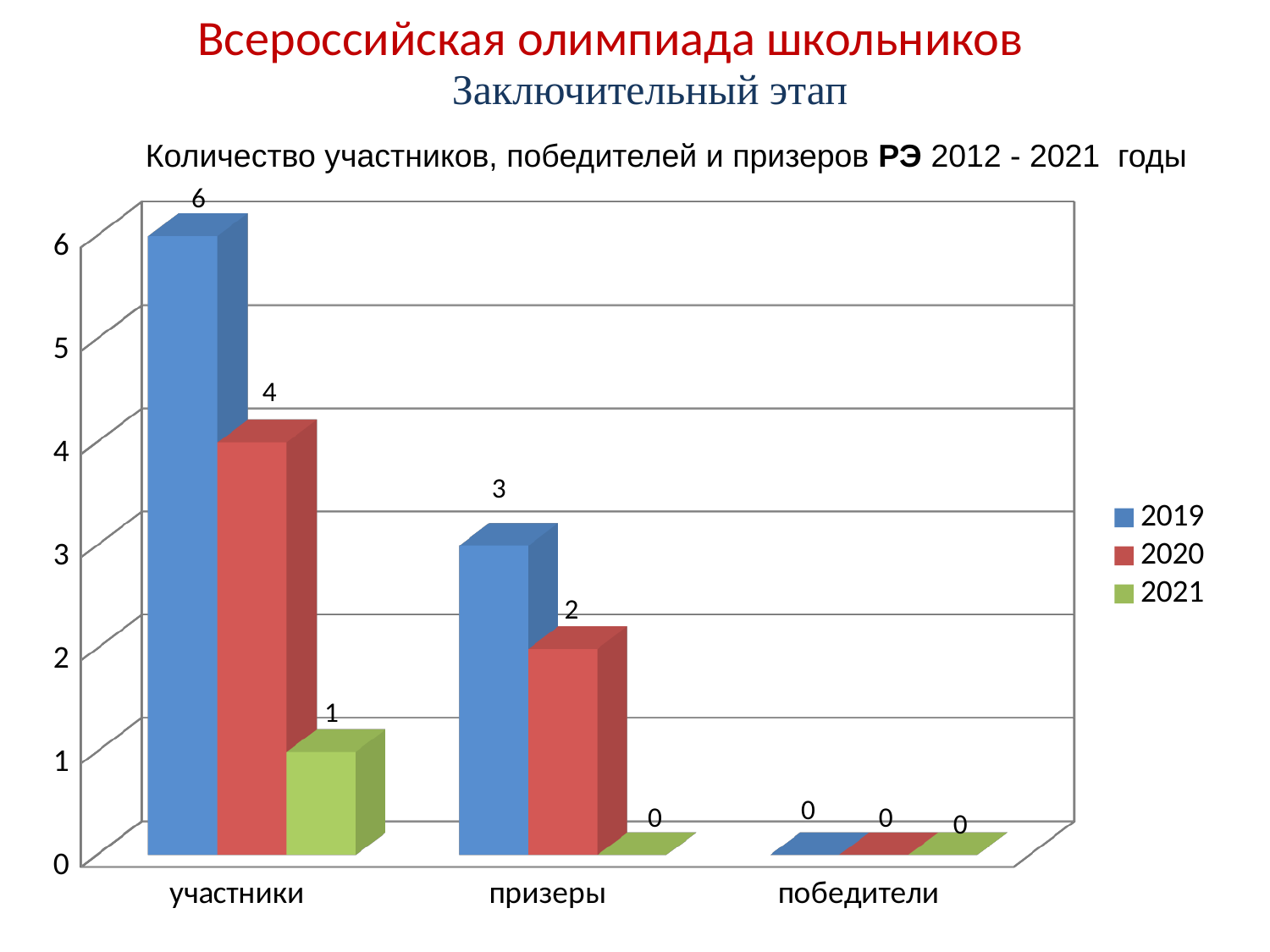
Which category has the lowest value in the 2019 series? победители What is the value for участники in the 2019 series? 6 What is the value for призеры in the 2020 series? 2 How many series does the legend list? 3 How many categories are shown on the x axis? 3 Which category has the highest value in the 2020 series? участники What is the value for победители in the 2019 series? 0 What is the difference between the 2019 and 2020 values for участники? 2 What is the value for участники in the 2021 series? 1 Which years are listed in the legend? 2019, 2020, 2021 What kind of chart is shown on the slide? bar chart Which is larger: the 2019 value for призеры or the 2020 value for участники? 2020 value for участники